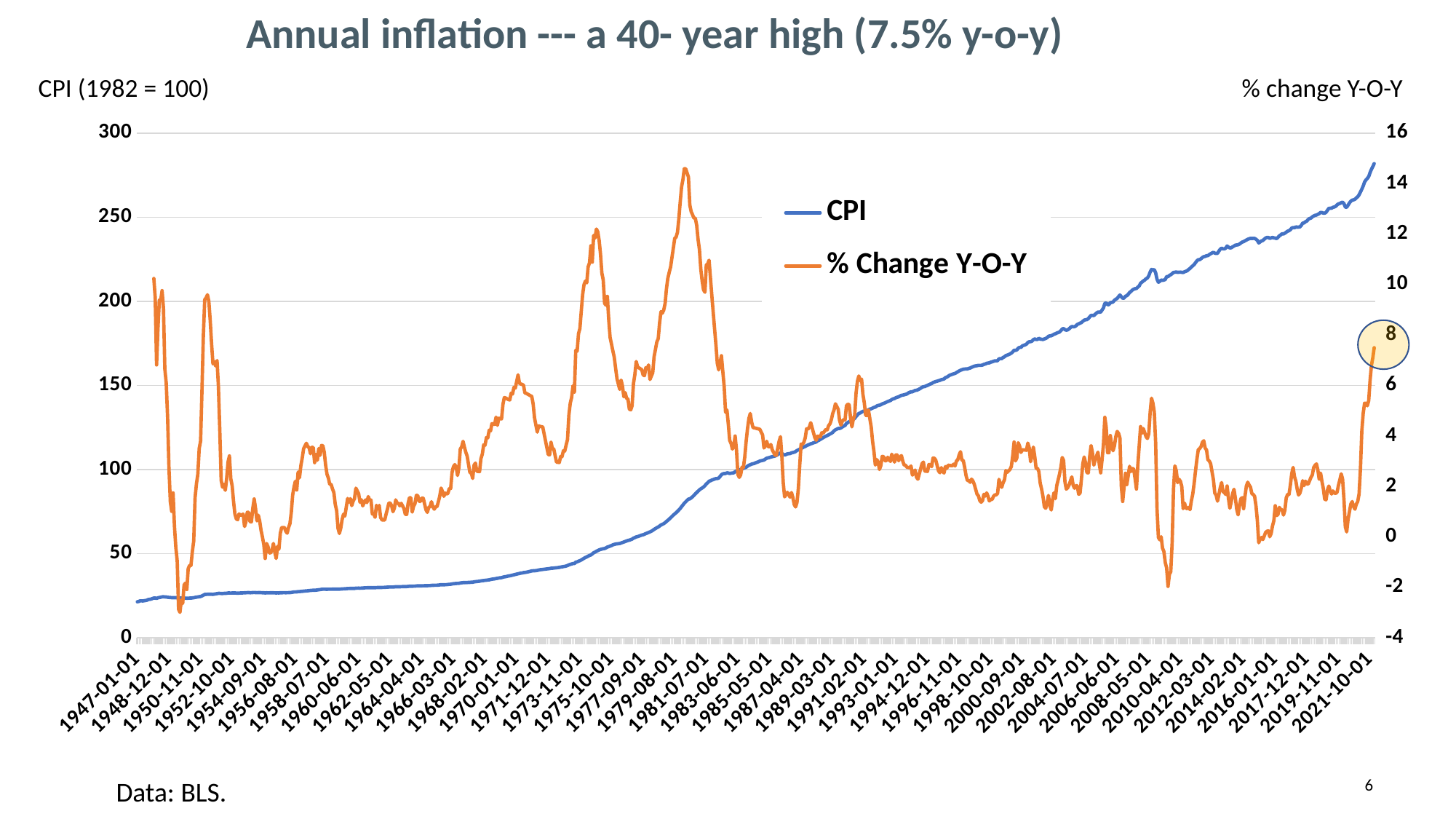
What are the two series named in the legend? CPI and % Change Y-O-Y Is the highest peak of the % Change Y-O-Y line greater or less than 12? greater What is the title of the chart? Annual inflation --- a 40- year high (7.5% y-o-y) How many series does the legend list? 2 What kind of chart is shown on the slide? line chart Is the CPI value at the start of the chart (1947-01-01) greater or less than 50? less What is the maximum value shown on the left (CPI) axis? 300 Does the CPI line rise or fall from 1947 to 2021? rise What annual inflation rate (y-o-y) is stated in the chart title? 7.5% Is the lowest point of the % Change Y-O-Y line (around 1949) greater or less than 0? less